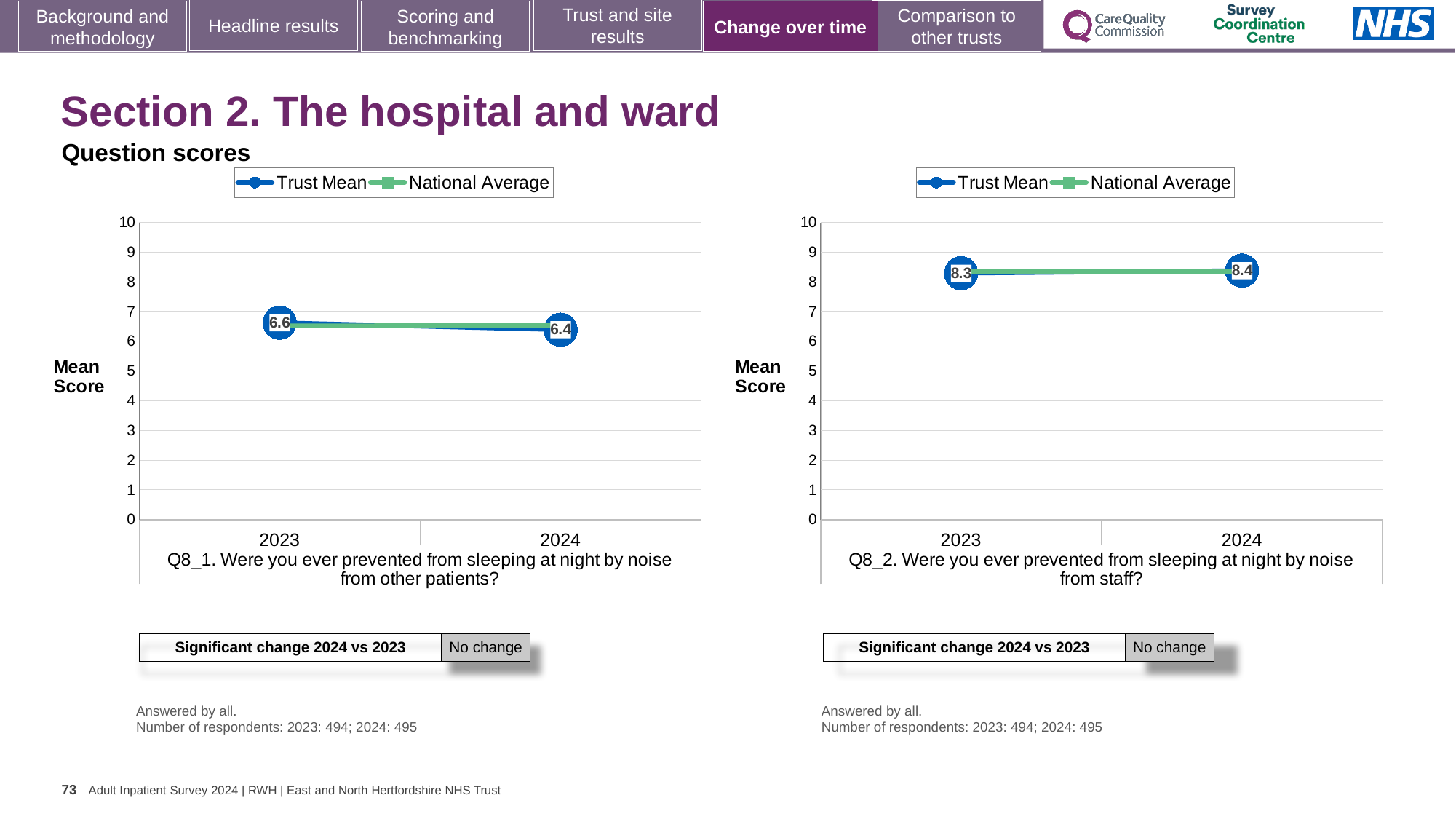
How many years are plotted on the x axis of the left chart (Q8_1)? 2 How many series does the legend of the left chart (Q8_1) list? 2 On the left chart (Q8_1), what is the Trust Mean score for 2024? 6.4 What kind of chart is the right chart (Q8_2)? line chart On the left chart (Q8_1), does the Trust Mean rise or fall from 2023 to 2024? fall On the right chart (Q8_2), what is the Trust Mean score for 2024? 8.4 On the right chart (Q8_2), what is the difference between the Trust Mean scores for 2024 and 2023? 0.1 On the left chart (Q8_1), what is the Trust Mean score for 2023? 6.6 On the right chart (Q8_2), what is the Trust Mean score for 2023? 8.3 On the left chart (Q8_1), what is the difference between the Trust Mean scores for 2023 and 2024? 0.2 On the right chart (Q8_2), is the Trust Mean for 2023 greater or less than 8? greater On the right chart (Q8_2), does the Trust Mean rise or fall from 2023 to 2024? rise